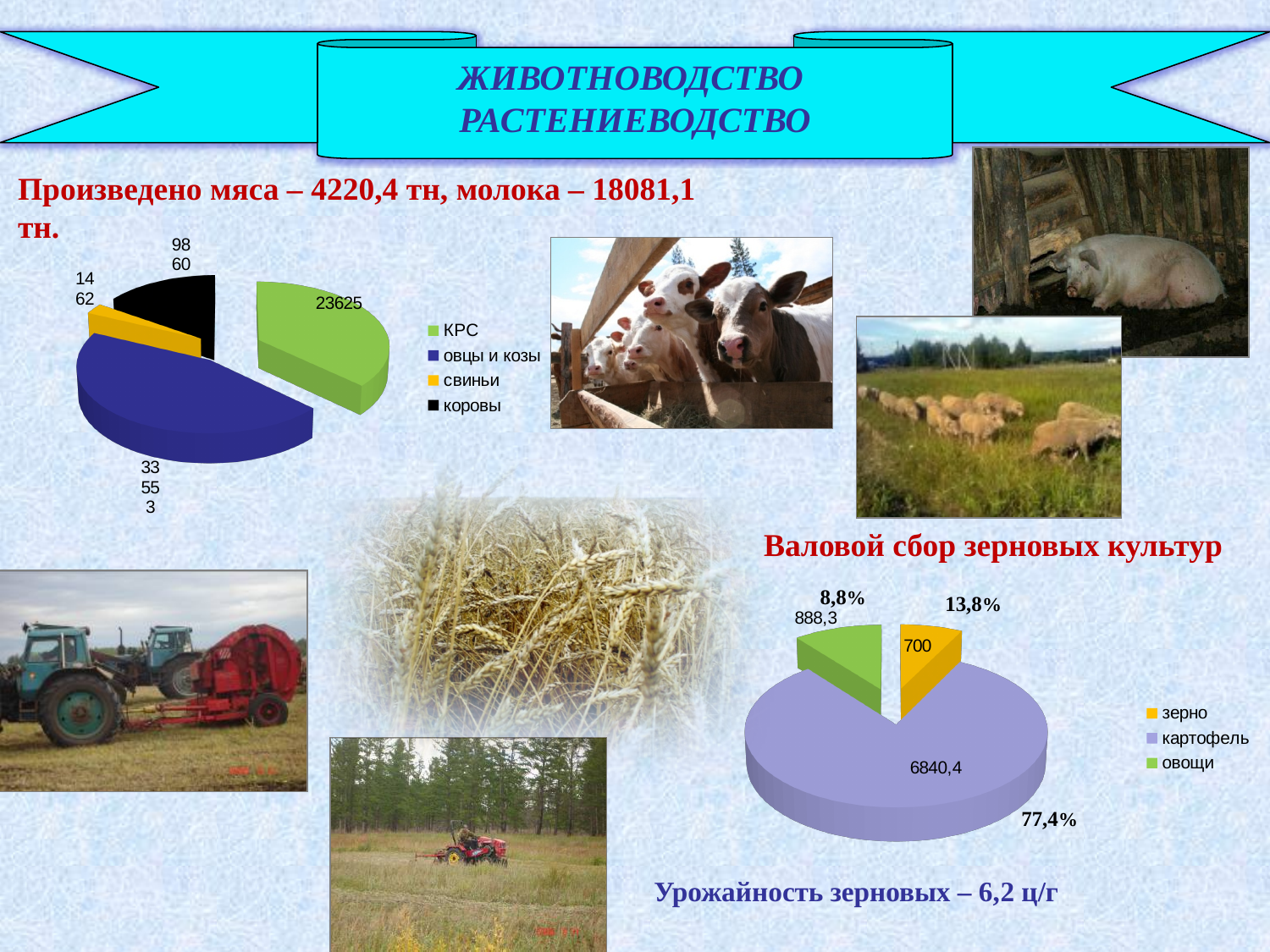
In the 'Валовой сбор зерновых культур' chart, what is the value for зерно? 700 In the 'Валовой сбор зерновых культур' chart, what share of the pie does картофель have? 77,4% In the left pie chart (livestock), what is the value for КРС? 23625 In the 'Валовой сбор зерновых культур' chart, which category is the largest? картофель In the 'Валовой сбор зерновых культур' chart, what is the value for картофель? 6840,4 In the 'Валовой сбор зерновых культур' chart, what is the value for овощи? 888,3 In the left pie chart (livestock), which category has the smallest slice? свиньи What type of chart is used for 'Валовой сбор зерновых культур'? pie chart In the left pie chart (livestock), which category has the largest slice? овцы и козы How many categories does the legend of the 'Валовой сбор зерновых культур' chart list? 3 In the 'Валовой сбор зерновых культур' chart, which category is the smallest? зерно In the 'Валовой сбор зерновых культур' chart, what share of the pie does овощи have? 8,8%